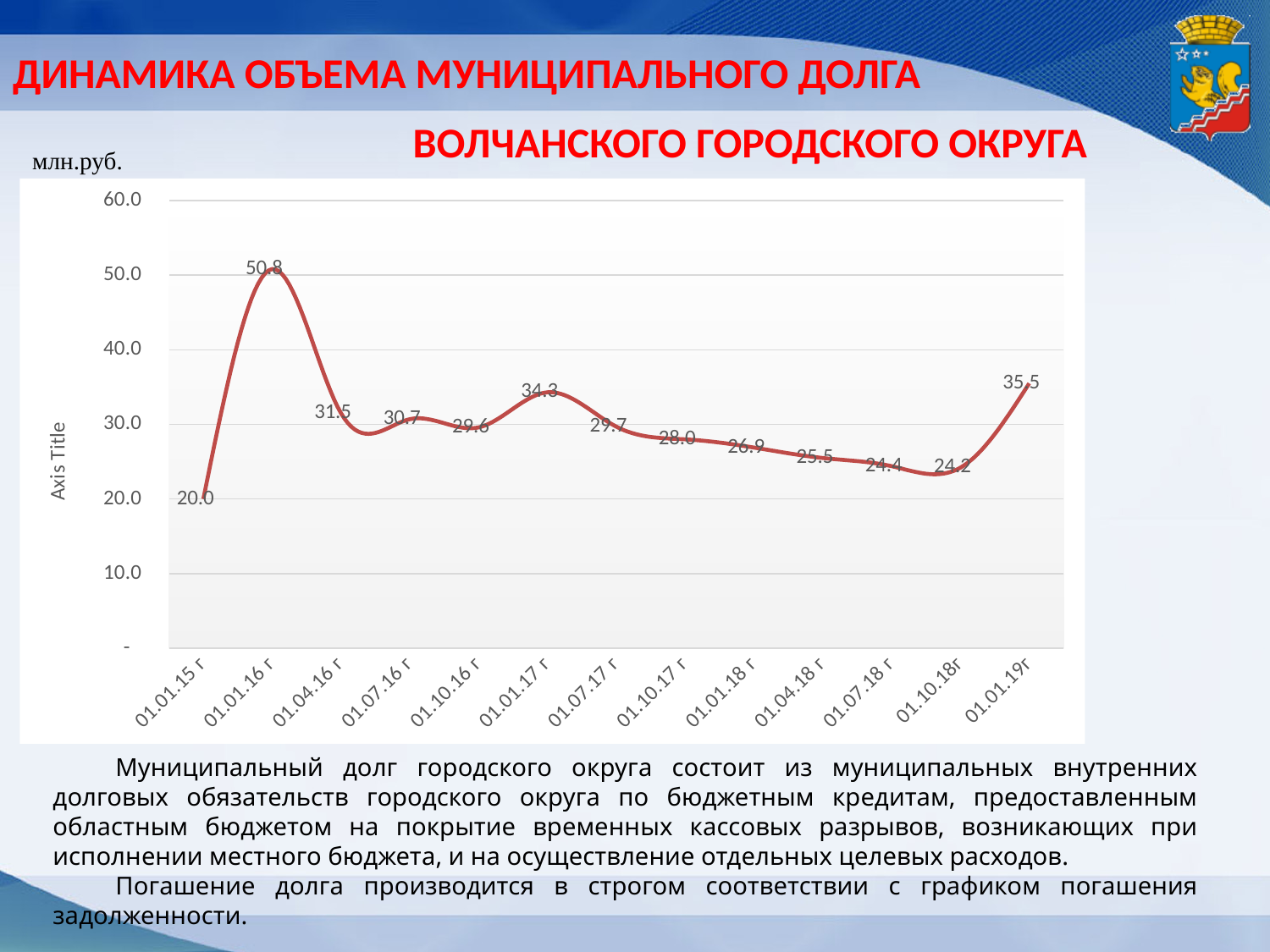
How many dates are plotted on the x axis? 13 What is the value for 01.01.16 г? 50.8 What is the value for 01.01.19г? 35.5 What is the value for 01.01.17 г? 34.3 What is the difference between the values for 01.01.17 г and 01.04.16 г? 2.8 Which date has the lowest value? 01.01.15 г What is the difference between the values for 01.01.16 г and 01.01.15 г? 30.8 Which is larger, the value for 01.01.17 г or the value for 01.07.17 г? 01.01.17 г Which date has the highest value? 01.01.16 г Is the value for 01.04.16 г greater or less than 30.0? greater What is the value for 01.01.15 г? 20.0 What kind of chart is shown on the slide? line chart